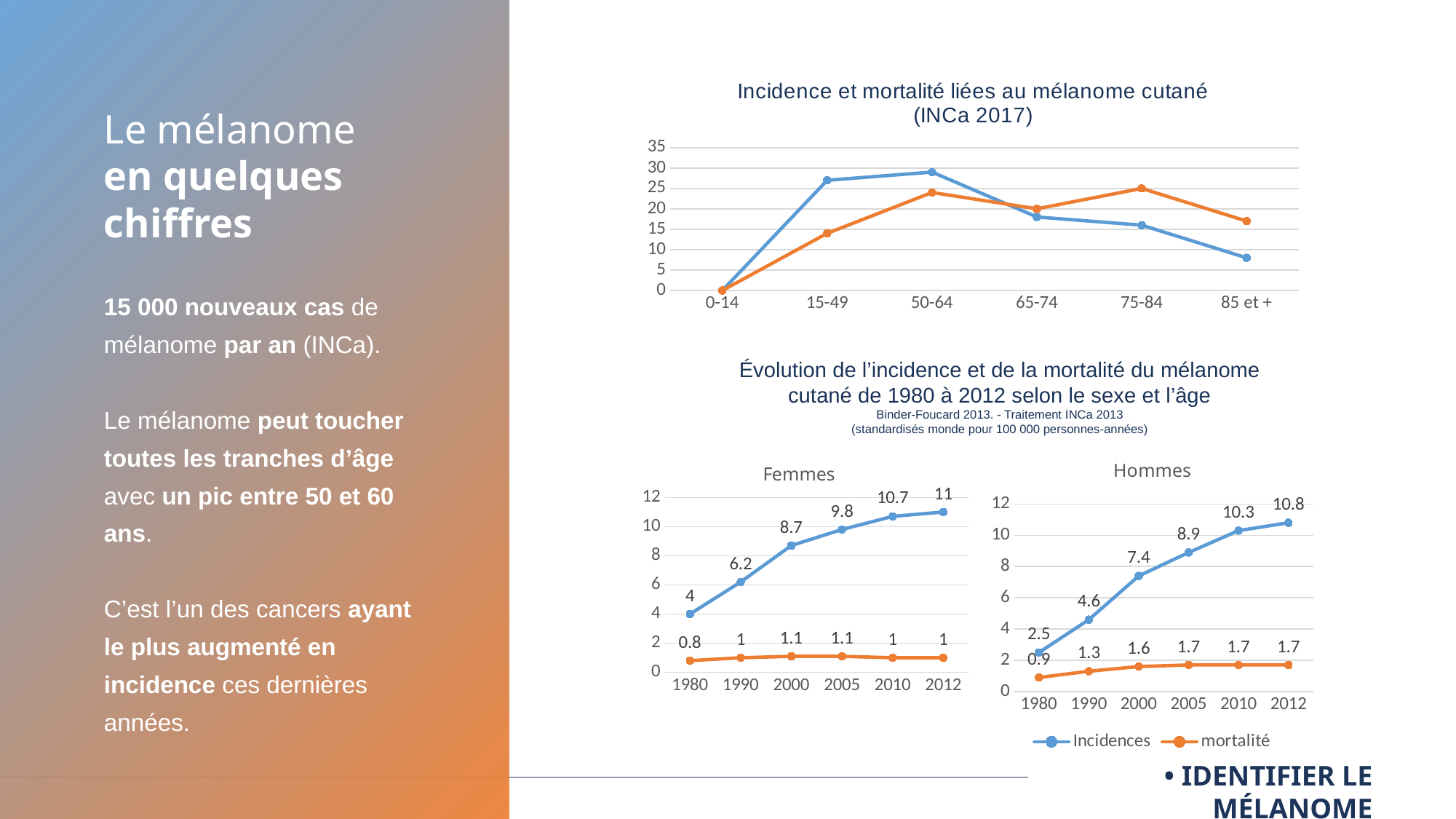
How many age categories are shown on the x axis of the top chart 'Incidence et mortalité liées au mélanome cutané (INCa 2017)'? 6 What kind of chart is the top chart titled 'Incidence et mortalité liées au mélanome cutané (INCa 2017)'? line chart How many series does the legend below the Hommes chart list? 2 In the Hommes chart, what is the mortalité value for 1980? 0.9 In the Femmes chart, what is the Incidences value for 2000? 8.7 In the top chart 'Incidence et mortalité liées au mélanome cutané (INCa 2017)', is the value of the blue line for 50-64 greater or less than 25? greater In the Hommes chart, what is the difference between the Incidences value in 2012 and in 1980? 8.3 In the Hommes chart, which year has the lowest Incidences value? 1980 In the Hommes chart, does the Incidences line rise or fall from 1980 to 2012? rises In the Hommes chart, what is the Incidences value for 2012? 10.8 Which is larger in 2012: the Incidences value in the Femmes chart or in the Hommes chart? Femmes In the Femmes chart, by how much did the Incidences value increase from 1980 to 2012? 7